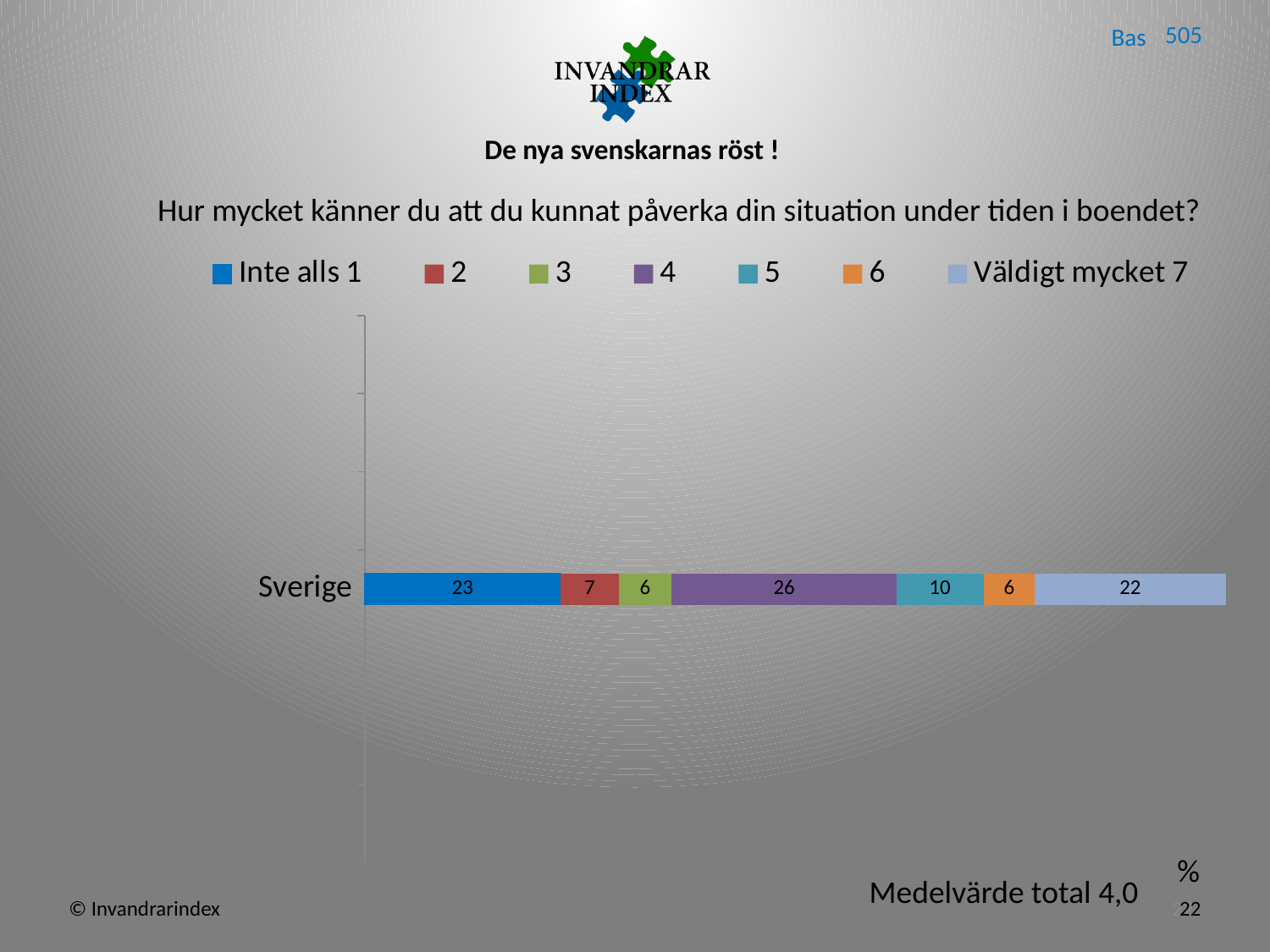
Which series has the highest value for Sverige? 4 What is the question shown as the chart title? Hur mycket känner du att du kunnat påverka din situation under tiden i boendet? How many categories are plotted on the chart? 1 Which is larger for Sverige: the value for series "Inte alls 1" or the value for series "Väldigt mycket 7"? Inte alls 1 What is the value for series "4" for Sverige? 26 What is the value for series "5" for Sverige? 10 What kind of chart is shown on the slide? Stacked bar chart What is the value for series "Inte alls 1" for Sverige? 23 What is the difference between the values for series "4" and series "Inte alls 1" for Sverige? 3 What is the value for series "Väldigt mycket 7" for Sverige? 22 What is the total of the stacked bar for Sverige? 100 How many series does the legend list? 7